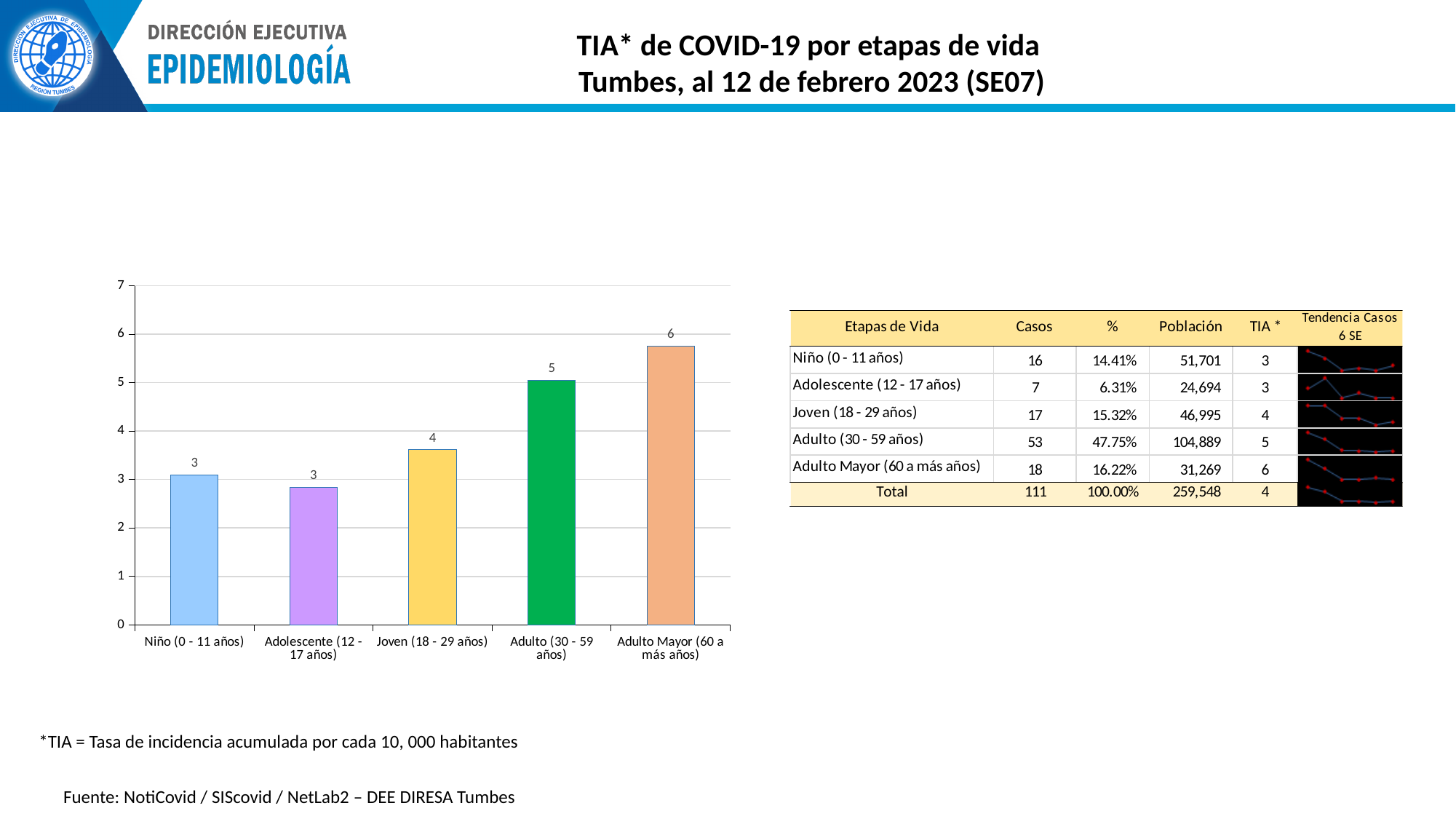
How many age-group categories are shown on the x axis of the bar chart? 5 Do the bar values generally rise or fall from Niño to Adulto Mayor along the x axis? rise Which age group has the highest bar in the chart? Adulto Mayor (60 a más años) What is the difference between the labelled values for Adulto Mayor (60 a más años) and Niño (0 - 11 años)? 3 What is the value shown for Niño (0 - 11 años) in the bar chart? 3 What is the value shown for Joven (18 - 29 años) in the bar chart? 4 Which is larger, the bar for Adulto (30 - 59 años) or the bar for Joven (18 - 29 años)? Adulto (30 - 59 años) What is the difference between the labelled values for Adulto Mayor (60 a más años) and Adulto (30 - 59 años)? 1 What is the value shown for Adulto (30 - 59 años) in the bar chart? 5 What is the value shown for Adulto Mayor (60 a más años) in the bar chart? 6 Is the value for Adulto (30 - 59 años) greater or less than 4? greater What kind of chart is shown on the slide? bar chart